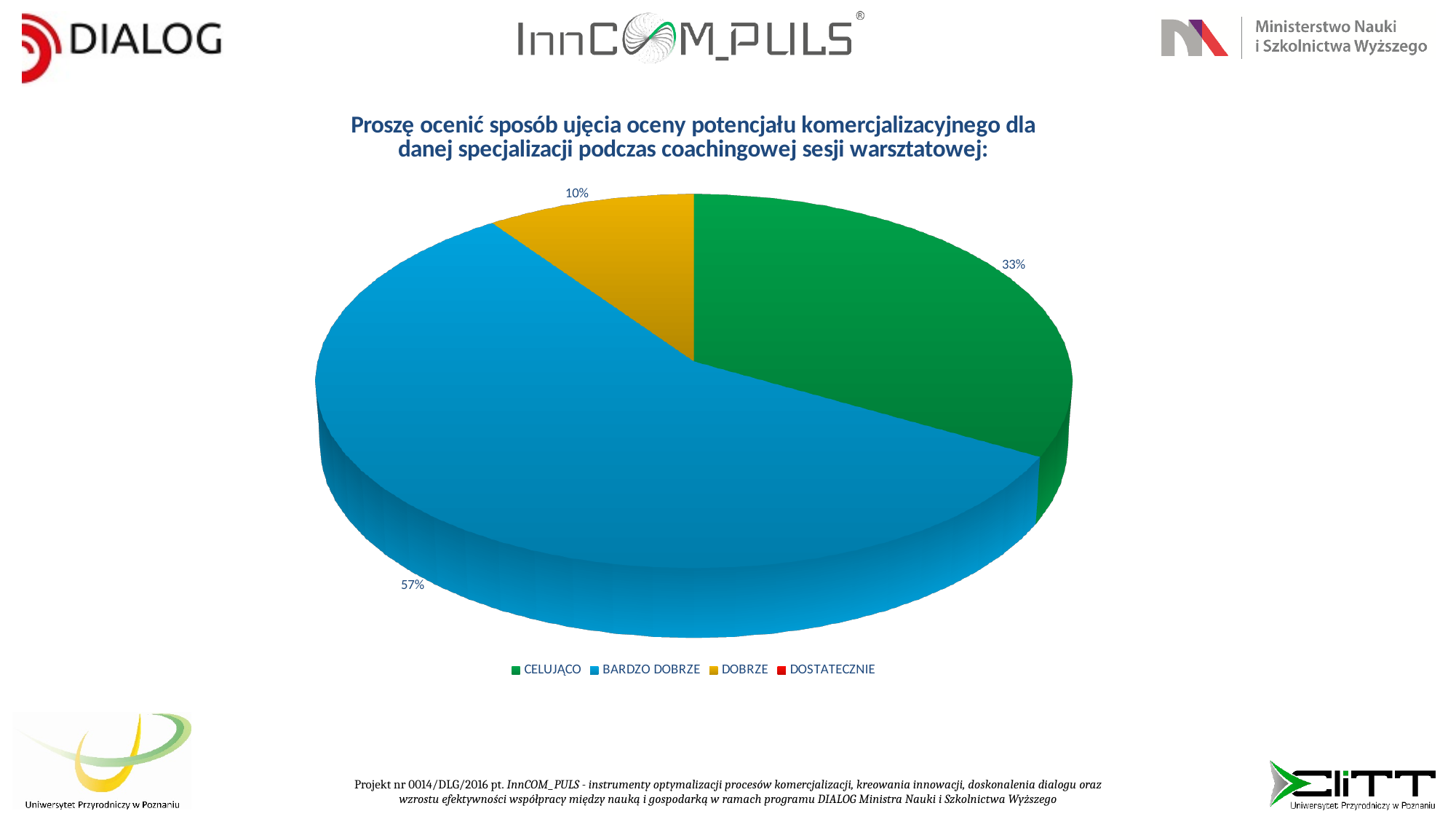
What is the difference in percentage points between CELUJĄCO and DOBRZE? 23 What share of the pie does CELUJĄCO have? 33% Which legend entry has no visible slice in the pie? DOSTATECZNIE What kind of chart is shown on the slide? pie chart What is the difference in percentage points between BARDZO DOBRZE and CELUJĄCO? 24 How many entries does the legend list? 4 Which category has the largest slice of the pie? BARDZO DOBRZE Which of the labelled slices is the smallest? DOBRZE What colour is the BARDZO DOBRZE slice? blue Which is larger, the CELUJĄCO slice or the DOBRZE slice? CELUJĄCO What share of the pie does BARDZO DOBRZE have? 57% What share of the pie does DOBRZE have? 10%